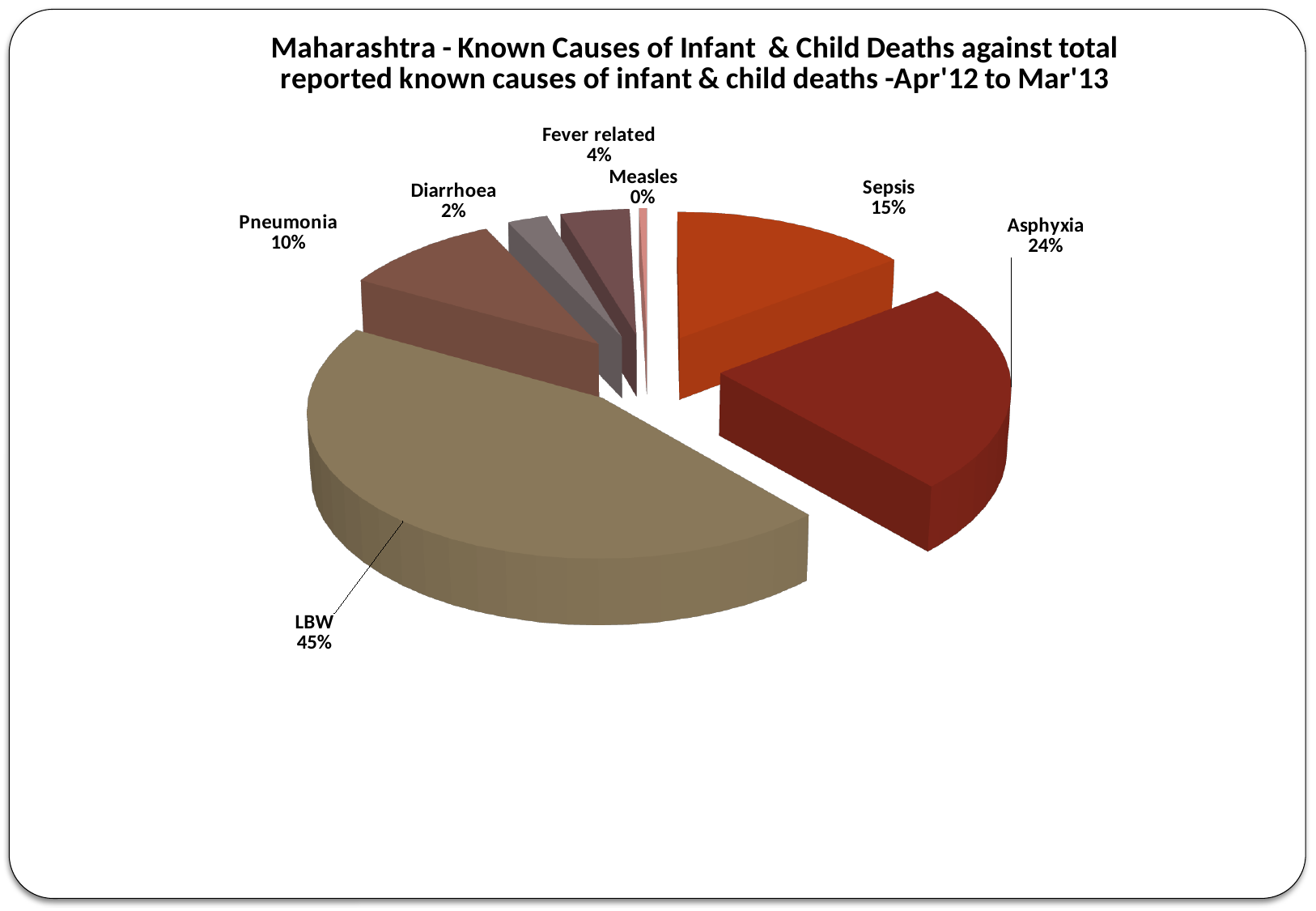
Which cause accounts for the largest share of the pie? LBW What percentage is shown for Asphyxia? 24% What percentage is shown for Measles? 0% What percentage is shown for Pneumonia? 10% What share of known causes of infant and child deaths is attributed to LBW? 45% Which is larger, the share for Pneumonia or the share for Fever related? Pneumonia What is the difference in percentage points between Asphyxia and Sepsis? 9 What percentage is shown for Sepsis? 15% How many causes are shown in the pie chart? 7 What period does the chart title say the data covers? Apr'12 to Mar'13 Which cause accounts for the smallest share of the pie? Measles What kind of chart is shown on the slide? Pie chart